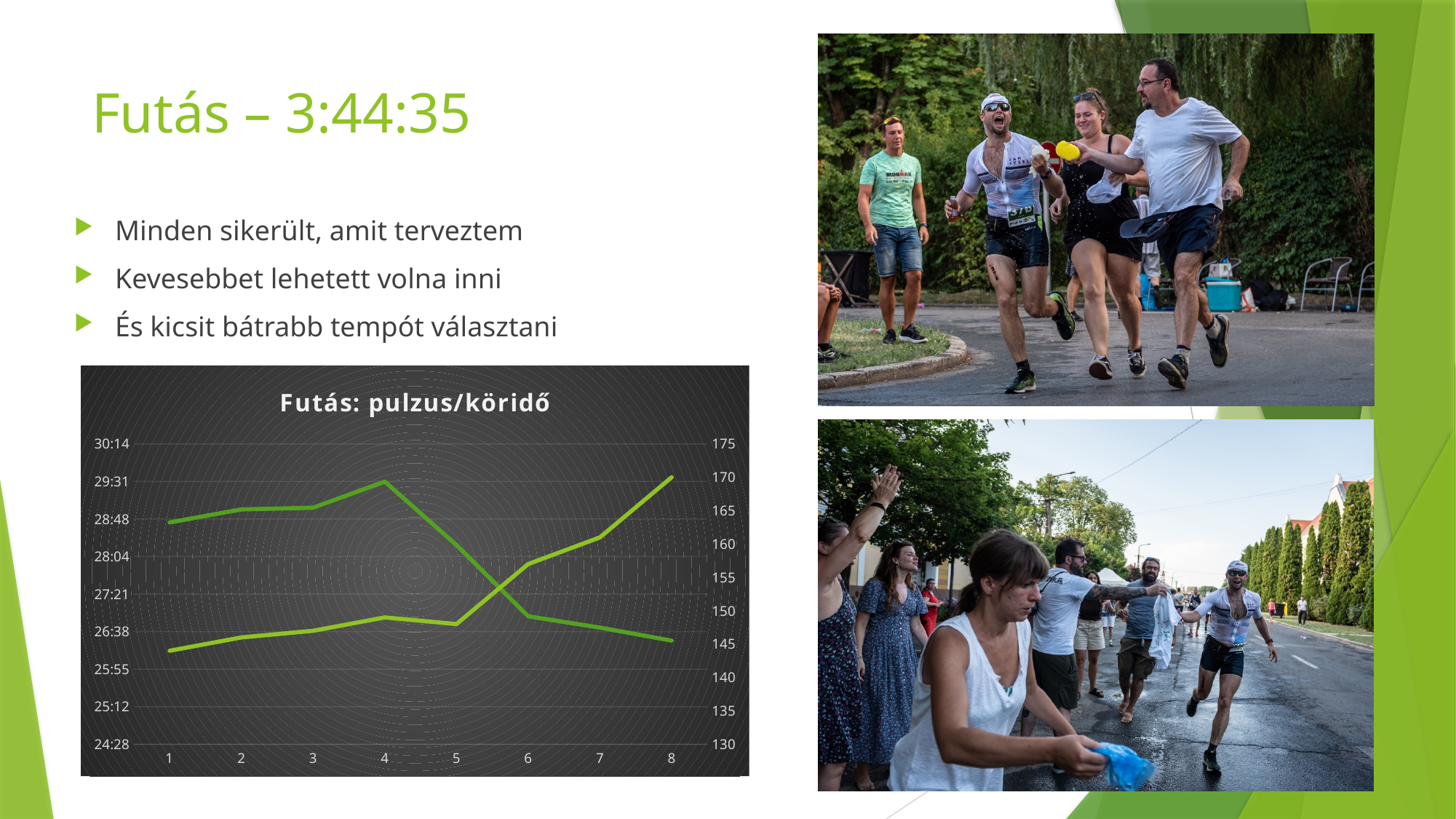
Read against the right-hand axis, is the lighter green line at point 8 greater or less than 165? greater At which x-axis point is the darker green line at its lowest? 8 What kind of chart is shown on the slide? line chart At which x-axis point does the darker green line reach its peak? 4 What is the title of the chart? Futás: pulzus/köridő Does the lighter green line rise or fall from point 1 to point 8? rises Is the darker green line higher at point 4 or at point 8? point 4 At which x-axis point is the lighter green line at its lowest? 1 At which x-axis point does the lighter green line reach its highest value? 8 How many points are plotted along the x axis of the chart? 8 Read against the right-hand axis, is the lighter green line at point 1 greater or less than 150? less How many lines are plotted on the chart? 2